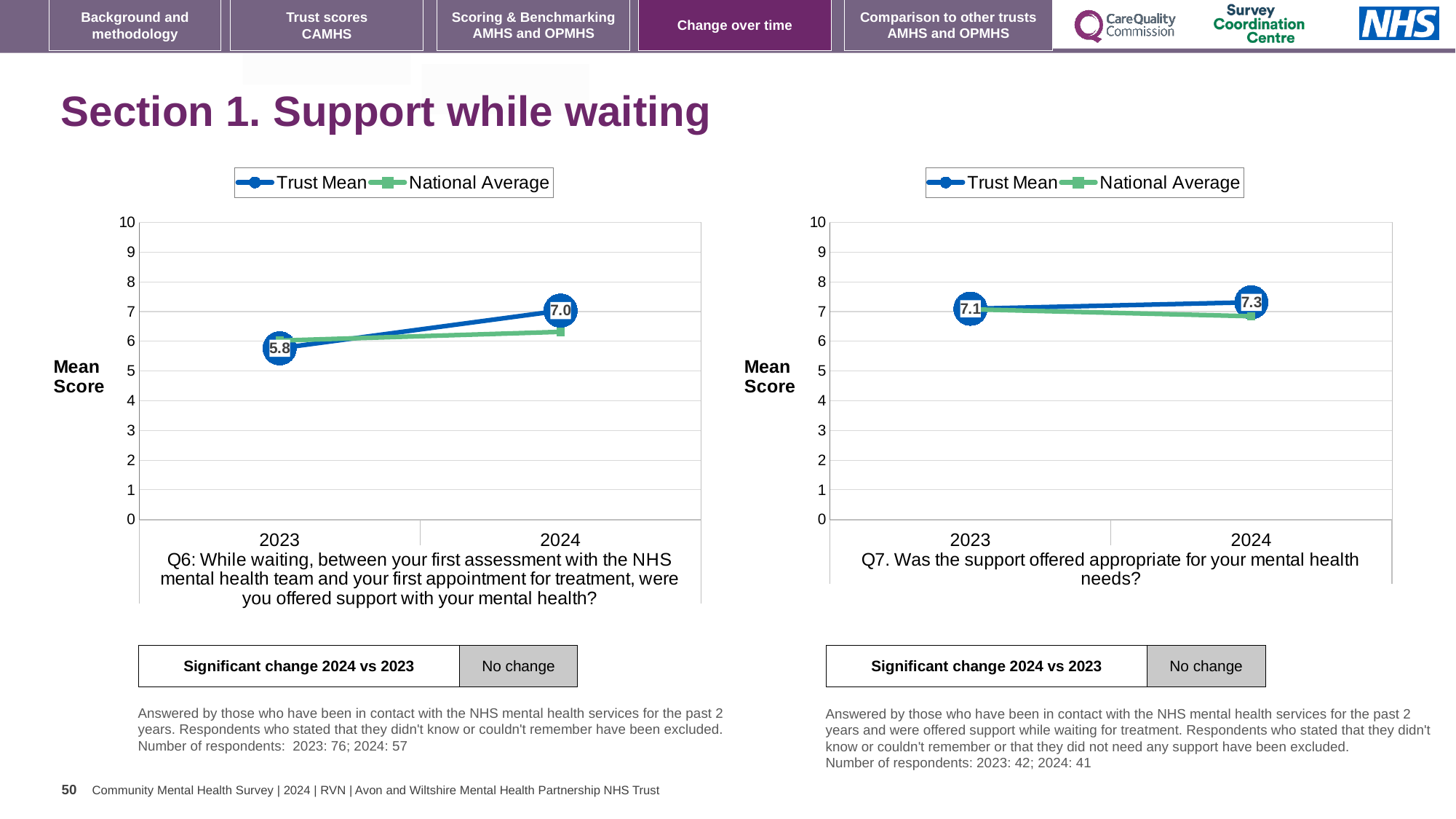
How many series does the legend of the right chart (Q7) list? 2 On the right chart (Q7), what is the difference between the Trust Mean in 2024 and 2023? 0.2 What type of chart is used on the left (Q6)? line chart On the left chart (Q6), what is the Trust Mean score for 2023? 5.8 On the right chart (Q7), what is the Trust Mean score for 2023? 7.1 On the left chart (Q6), is the National Average for 2024 greater or less than 7? less On the right chart (Q7), what is the Trust Mean score for 2024? 7.3 On the right chart (Q7), does the National Average rise or fall from 2023 to 2024? fall On the left chart (Q6), what is the Trust Mean score for 2024? 7.0 On the left chart (Q6), does the Trust Mean rise or fall from 2023 to 2024? rise On the left chart (Q6), which year has the higher Trust Mean, 2023 or 2024? 2024 On the left chart (Q6), by how much did the Trust Mean change from 2023 to 2024? 1.2